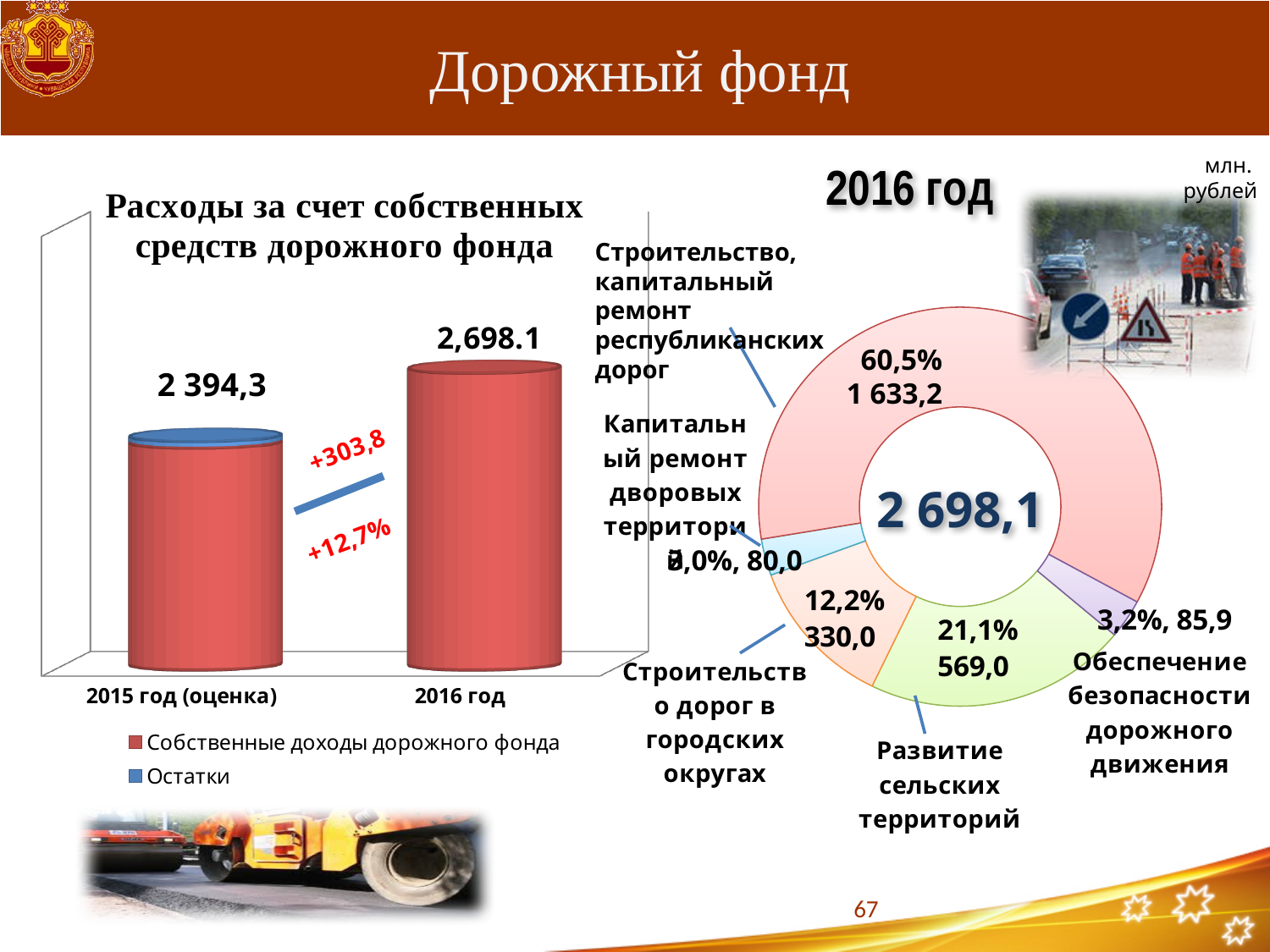
What kind of chart is the chart on the left of the slide? bar chart How many series does the legend of the bar chart on the left list? 2 In the bar chart on the left, do the values rise or fall from 2015 год (оценка) to 2016 год? rise In the doughnut chart '2016 год', what share does Строительство, капитальный ремонт республиканских дорог have? 60,5% What total value is shown in the centre of the doughnut chart '2016 год'? 2 698,1 In the bar chart 'Расходы за счет собственных средств дорожного фонда', what is the value shown for 2015 год (оценка)? 2 394,3 In the bar chart 'Расходы за счет собственных средств дорожного фонда', what is the value shown for 2016 год? 2,698.1 In the doughnut chart '2016 год', what share does Строительство дорог в городских округах have? 12,2% In the doughnut chart '2016 год', which is larger: Обеспечение безопасности дорожного движения or Развитие сельских территорий? Развитие сельских территорий In the doughnut chart '2016 год', what value is shown for Развитие сельских территорий? 569,0 In the bar chart on the left, by how much does the 2016 год value exceed the 2015 год (оценка) value? +303,8 In the doughnut chart '2016 год', which category has the largest share? Строительство, капитальный ремонт республиканских дорог